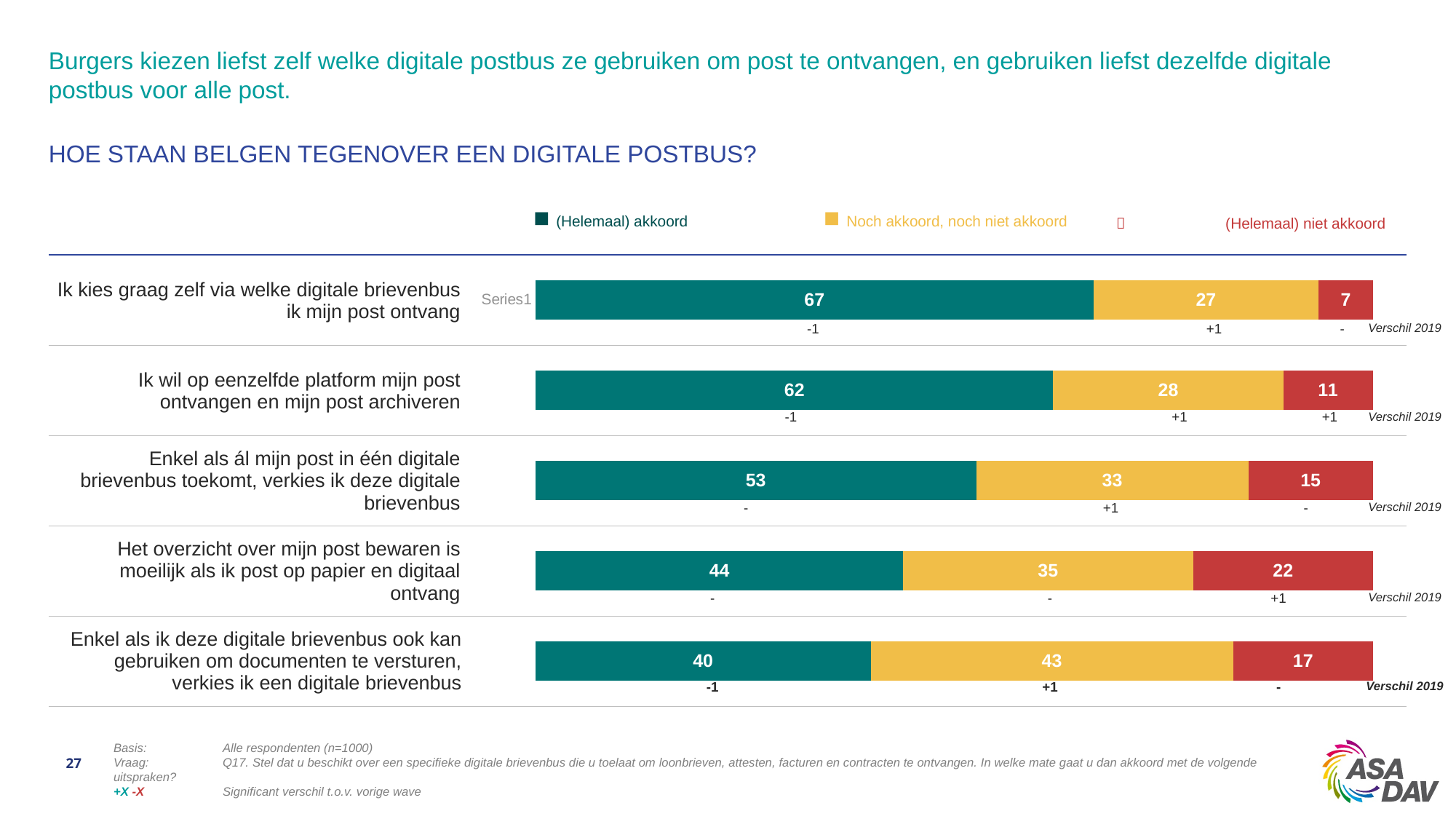
Across the five statements, which statement has the lowest (Helemaal) niet akkoord value? Ik kies graag zelf via welke digitale brievenbus ik mijn post ontvang In the chart for 'Het overzicht over mijn post bewaren is moeilijk als ik post op papier en digitaal ontvang', what is the value for (Helemaal) niet akkoord? 22 In the chart for 'Enkel als ik deze digitale brievenbus ook kan gebruiken om documenten te versturen, verkies ik een digitale brievenbus', which is larger: (Helemaal) akkoord or Noch akkoord, noch niet akkoord? Noch akkoord, noch niet akkoord How many series does the legend list? 3 How many statements are shown with a bar on the slide? 5 What colour represents (Helemaal) niet akkoord in the legend? Red Across the five statements, which statement has the highest (Helemaal) akkoord value? Ik kies graag zelf via welke digitale brievenbus ik mijn post ontvang What kind of chart is used to show the responses for each statement? Stacked bar chart In the chart for 'Ik kies graag zelf via welke digitale brievenbus ik mijn post ontvang', what is the value for (Helemaal) akkoord? 67 In the chart for 'Ik wil op eenzelfde platform mijn post ontvangen en mijn post archiveren', what is the difference between the (Helemaal) akkoord value and the (Helemaal) niet akkoord value? 51 In the chart for 'Enkel als ik deze digitale brievenbus ook kan gebruiken om documenten te versturen, verkies ik een digitale brievenbus', what is the value for Noch akkoord, noch niet akkoord? 43 In the chart for 'Enkel als ál mijn post in één digitale brievenbus toekomt, verkies ik deze digitale brievenbus', what is the total of the three segments? 101